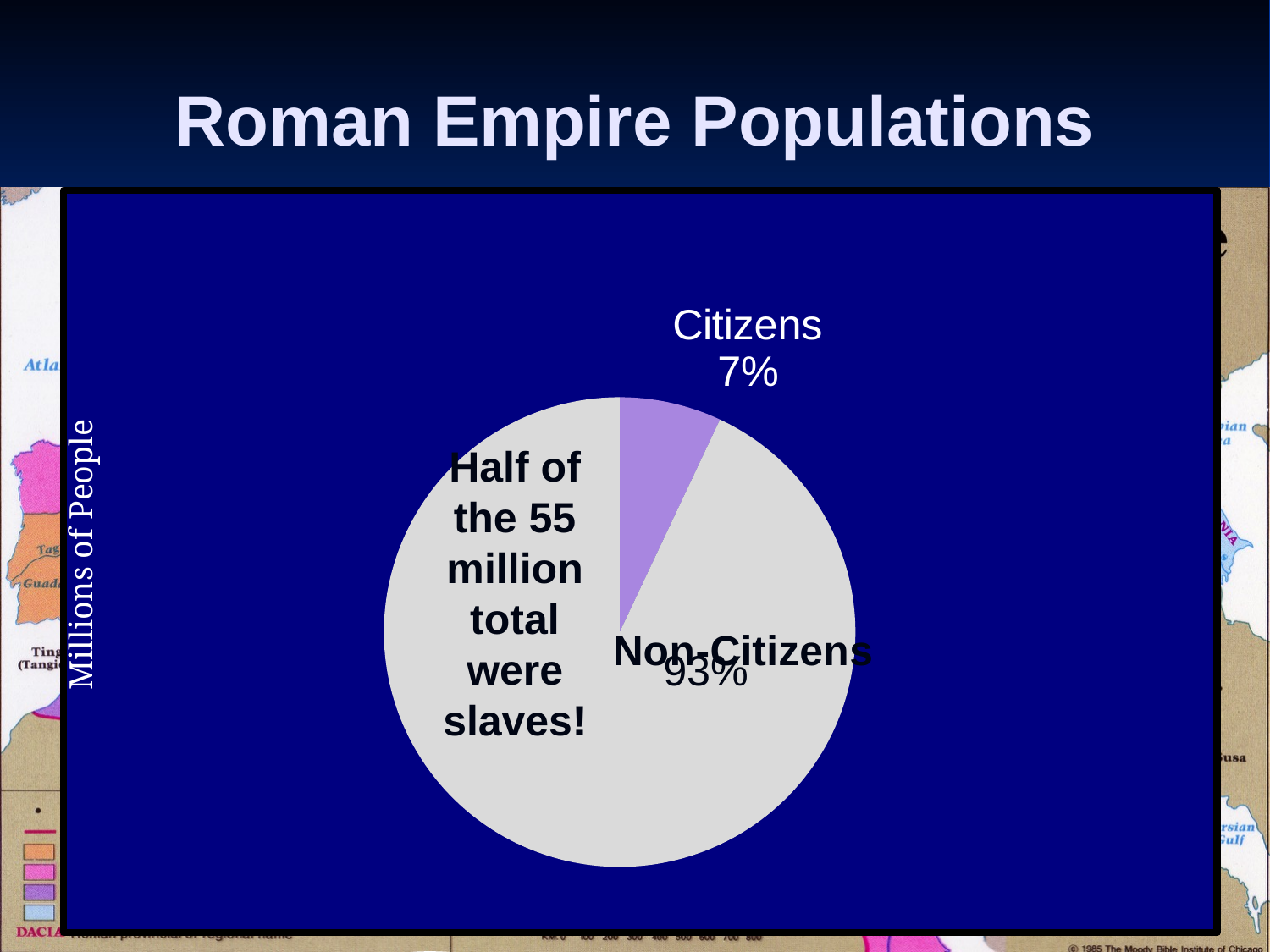
What colour is the Citizens slice of the pie? purple Which is larger, the Citizens slice or the Non-Citizens slice? Non-Citizens According to the text on the chart, what was the total population in millions? 55 million What is the difference in percentage points between the Non-Citizens share and the Citizens share? 86 How many slices does the pie chart have? 2 What kind of chart is shown on the slide? pie chart What share of the pie is labelled Citizens? 7% Which slice of the pie is the smallest? Citizens What share of the pie is labelled Non-Citizens? 93% What is the title of the slide containing the pie chart? Roman Empire Populations Which slice of the pie is the largest? Non-Citizens